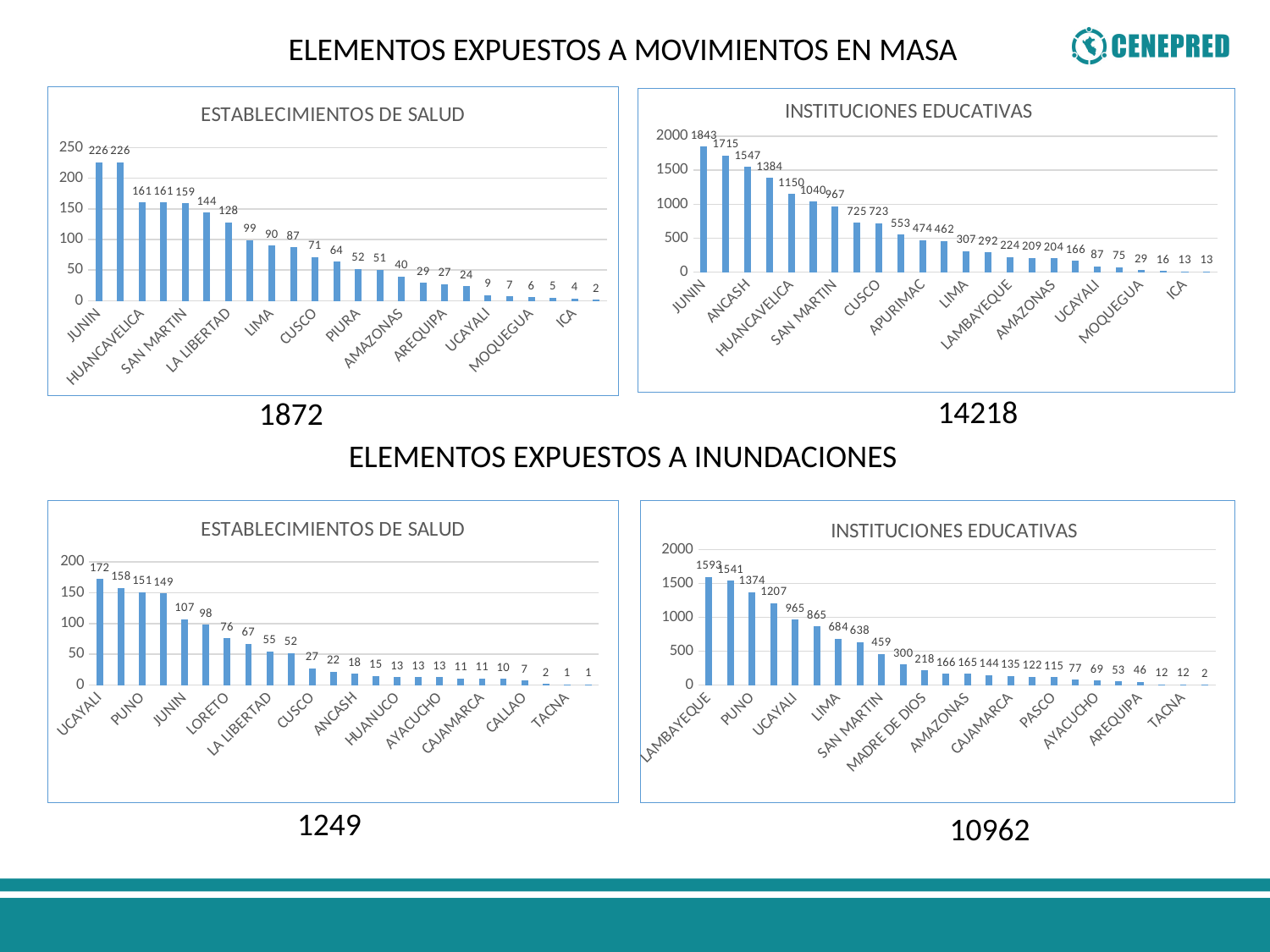
In the bottom-left chart (ESTABLECIMIENTOS DE SALUD, inundaciones), what is the value for UCAYALI? 172 In the bottom-left chart (ESTABLECIMIENTOS DE SALUD, inundaciones), do the values rise or fall from left to right along the x axis? Fall In the bottom-right chart (INSTITUCIONES EDUCATIVAS, inundaciones), what is the difference between the two highest values, 1593 and 1541? 52 In the top-right chart (INSTITUCIONES EDUCATIVAS, movimientos en masa), which region has the highest value? JUNIN In the top-left chart (ESTABLECIMIENTOS DE SALUD, movimientos en masa), what is the value for JUNIN? 226 In the top-right chart (INSTITUCIONES EDUCATIVAS, movimientos en masa), what is the value for JUNIN? 1843 In the top-right chart (INSTITUCIONES EDUCATIVAS, movimientos en masa), what is the difference between the two highest values, 1843 and 1715? 128 What total is printed below the top-right chart (INSTITUCIONES EDUCATIVAS, movimientos en masa)? 14218 Which is larger: the value for JUNIN in the top-right chart (INSTITUCIONES EDUCATIVAS, movimientos en masa) or the value for LAMBAYEQUE in the bottom-right chart (INSTITUCIONES EDUCATIVAS, inundaciones)? JUNIN in the top-right chart What kind of chart is the top-left chart (ESTABLECIMIENTOS DE SALUD, movimientos en masa)? Bar chart In the bottom-right chart (INSTITUCIONES EDUCATIVAS, inundaciones), which region has the highest value? LAMBAYEQUE In the bottom-right chart (INSTITUCIONES EDUCATIVAS, inundaciones), what is the value for LAMBAYEQUE? 1593